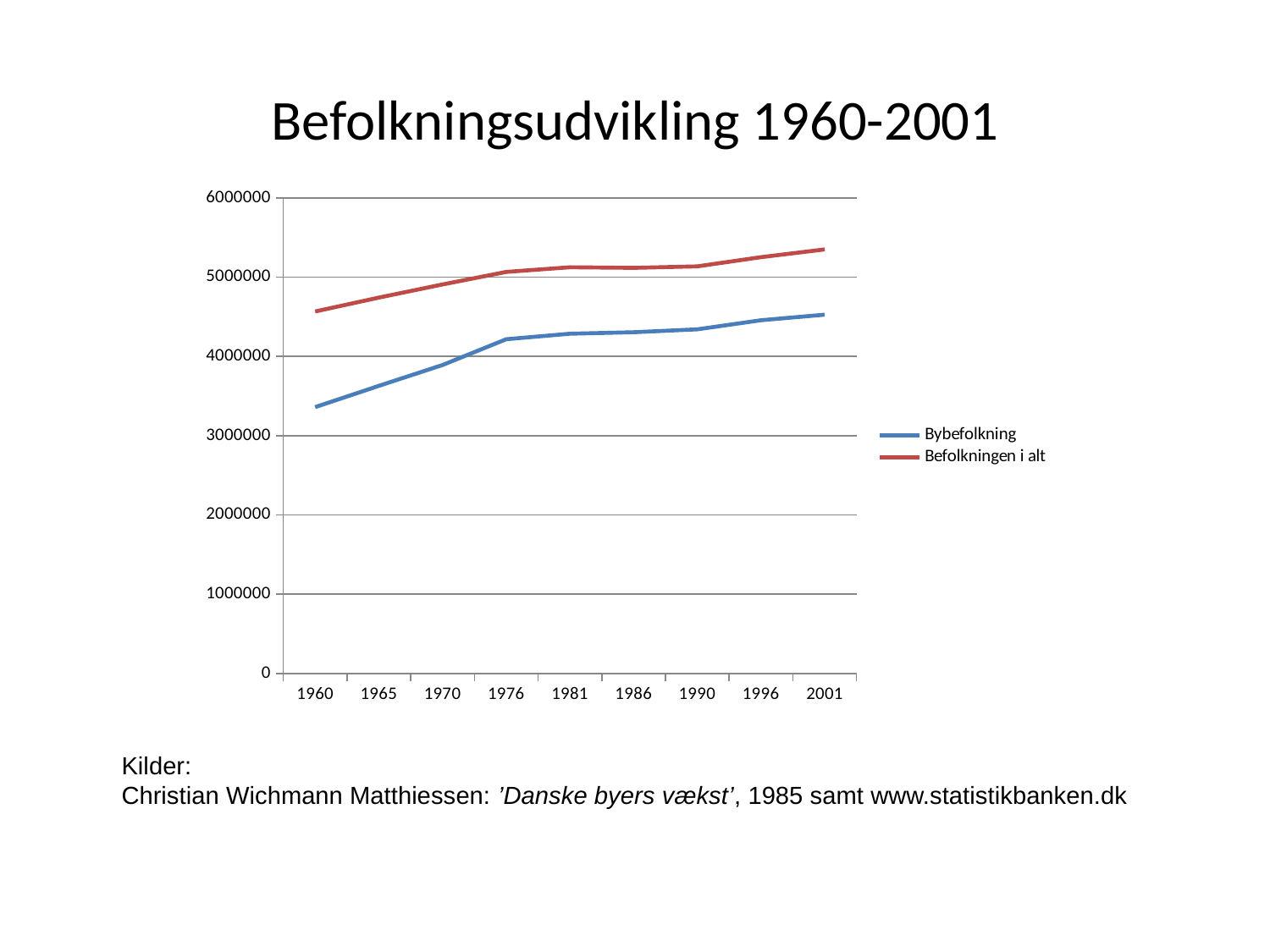
Is the value for Bybefolkning in 1960 greater or less than 3000000? greater Is the value for Befolkningen i alt in 2001 greater or less than 5000000? greater In which year is the value for Bybefolkning highest? 2001 Do the values for Bybefolkning rise or fall from 1960 to 2001? rise What kind of chart is shown on the slide? line chart What is the title of the chart? Befolkningsudvikling 1960-2001 How many years are plotted along the x axis? 9 How many series does the legend list? 2 Is the value for Bybefolkning in 1960 greater or less than 4000000? less In 1990, which series has the larger value, Bybefolkning or Befolkningen i alt? Befolkningen i alt Which series is drawn in red? Befolkningen i alt